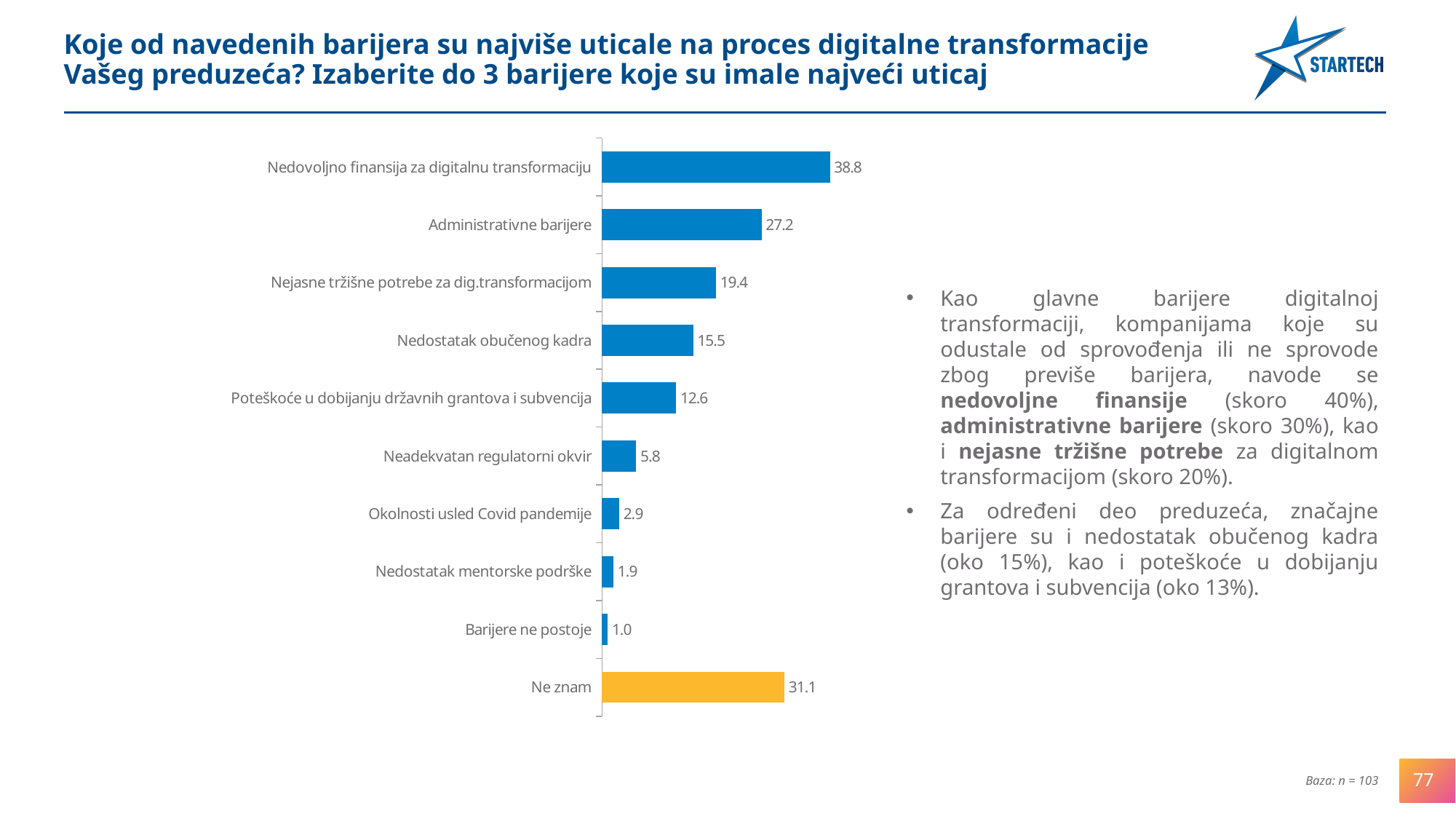
Which category has the highest value? Nedovoljno finansija za digitalnu transformaciju What is the difference between the values for Nedovoljno finansija za digitalnu transformaciju and Administrativne barijere? 11.6 What is the value for Ne znam? 31.1 Which is larger: the value for Ne znam or the value for Administrativne barijere? Ne znam What is the value for Administrativne barijere? 27.2 How many categories are shown in the chart? 10 Which bar is shown in a different colour (orange) from the others? Ne znam What is the value for Nedostatak obučenog kadra? 15.5 Which category has the lowest value? Barijere ne postoje What is the difference between the values for Nejasne tržišne potrebe za dig.transformacijom and Nedostatak obučenog kadra? 3.9 What is the value for Nedovoljno finansija za digitalnu transformaciju? 38.8 What kind of chart is shown on the slide? Bar chart